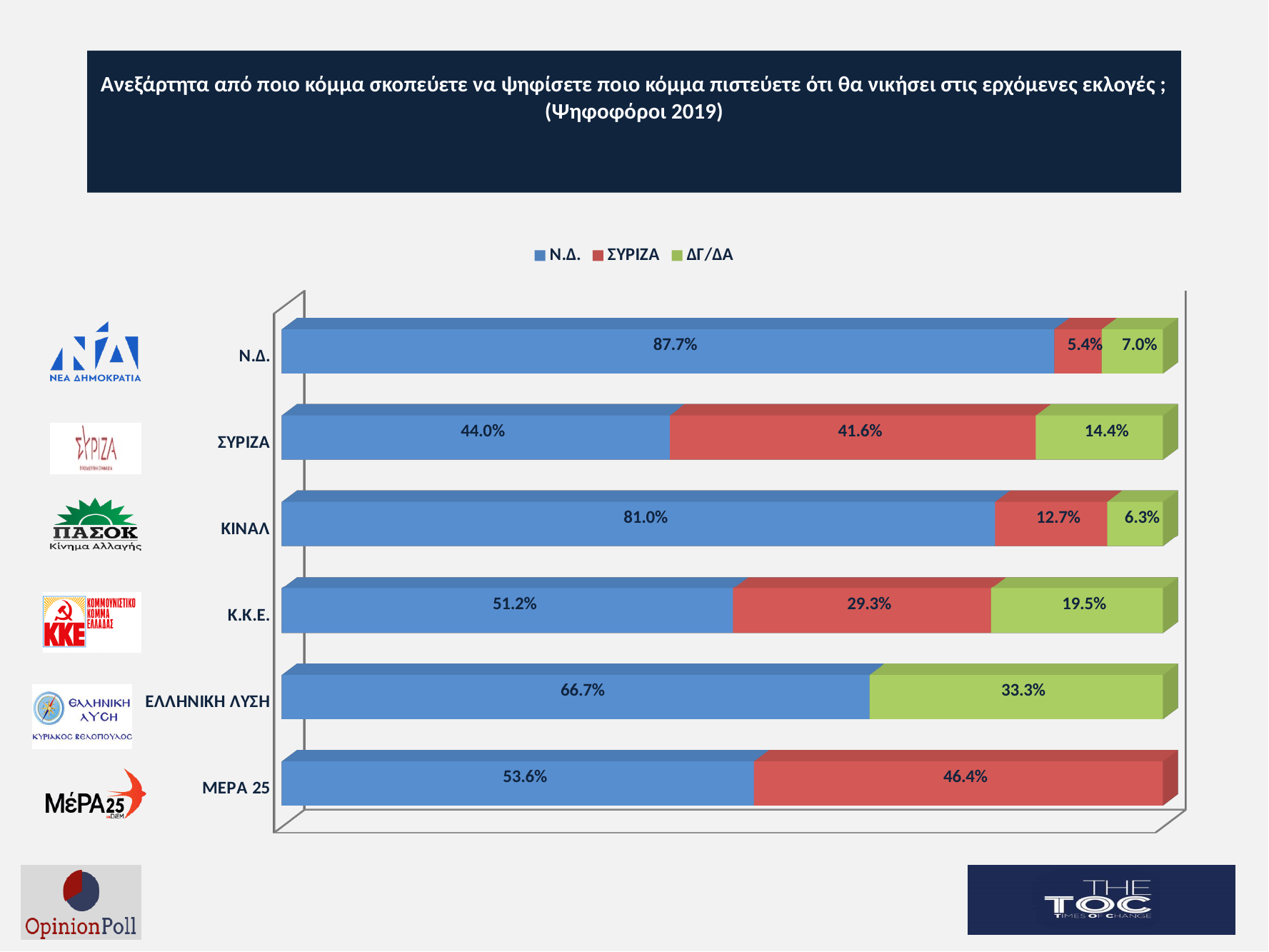
How many voter groups (categories) are shown in the chart? 6 Which is larger for Κ.Κ.Ε. voters: the Ν.Δ. value or the ΣΥΡΙΖΑ value? Ν.Δ. What kind of chart is shown on the slide? Stacked bar chart What is the difference between the Ν.Δ. value and the ΣΥΡΙΖΑ value for ΣΥΡΙΖΑ voters? 2.4% What percentage of ΣΥΡΙΖΑ voters (2019) believe Ν.Δ. will win the next elections? 44.0% What is the ΣΥΡΙΖΑ series value for ΚΙΝΑΛ voters? 12.7% What is the ΔΓ/ΔΑ value for Κ.Κ.Ε. voters? 19.5% What is the ΣΥΡΙΖΑ series value for ΜΕΡΑ 25 voters? 46.4% Which voter group has the lowest Ν.Δ. value? ΣΥΡΙΖΑ How many series does the legend list? 3 Which colour represents the ΔΓ/ΔΑ series in the chart? Green Which voter group has the highest Ν.Δ. value? Ν.Δ.